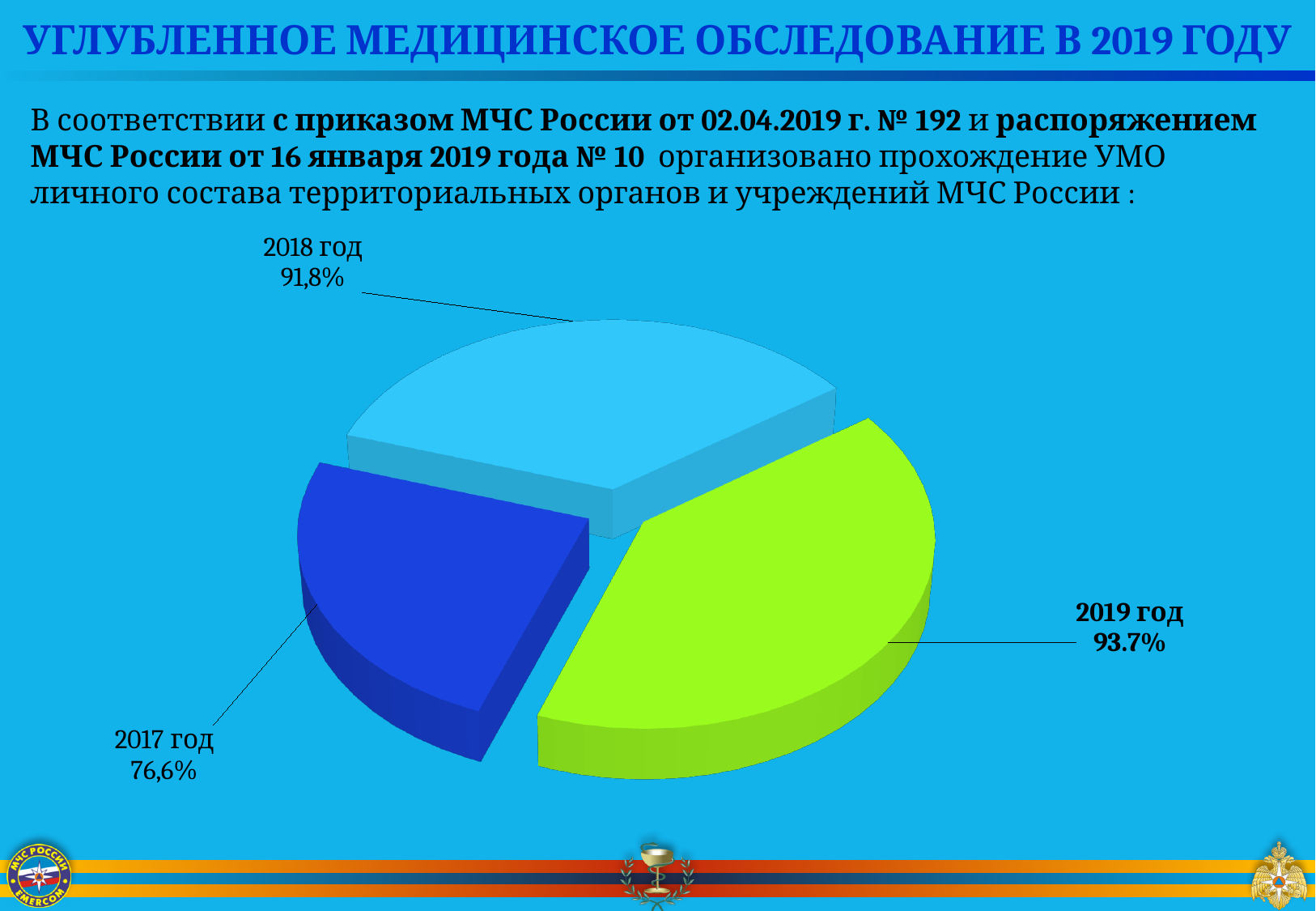
Which is larger, the value for 2018 год or the value for 2019 год? 2019 год What value is shown for 2019 год on the pie chart? 93.7% How many slices does the pie chart have? 3 Which year has the highest value on the pie chart? 2019 год Which is larger, the value for 2019 год or the value for 2017 год? 2019 год What colour is the slice for 2019 год? Green What is the difference between the values for 2018 год and 2017 год? 15,2% What kind of chart is shown on the slide? Pie chart Do the values rise or fall from 2017 год to 2019 год? Rise What value is shown for 2017 год on the pie chart? 76,6% What value is shown for 2018 год on the pie chart? 91,8% Which year has the lowest value on the pie chart? 2017 год